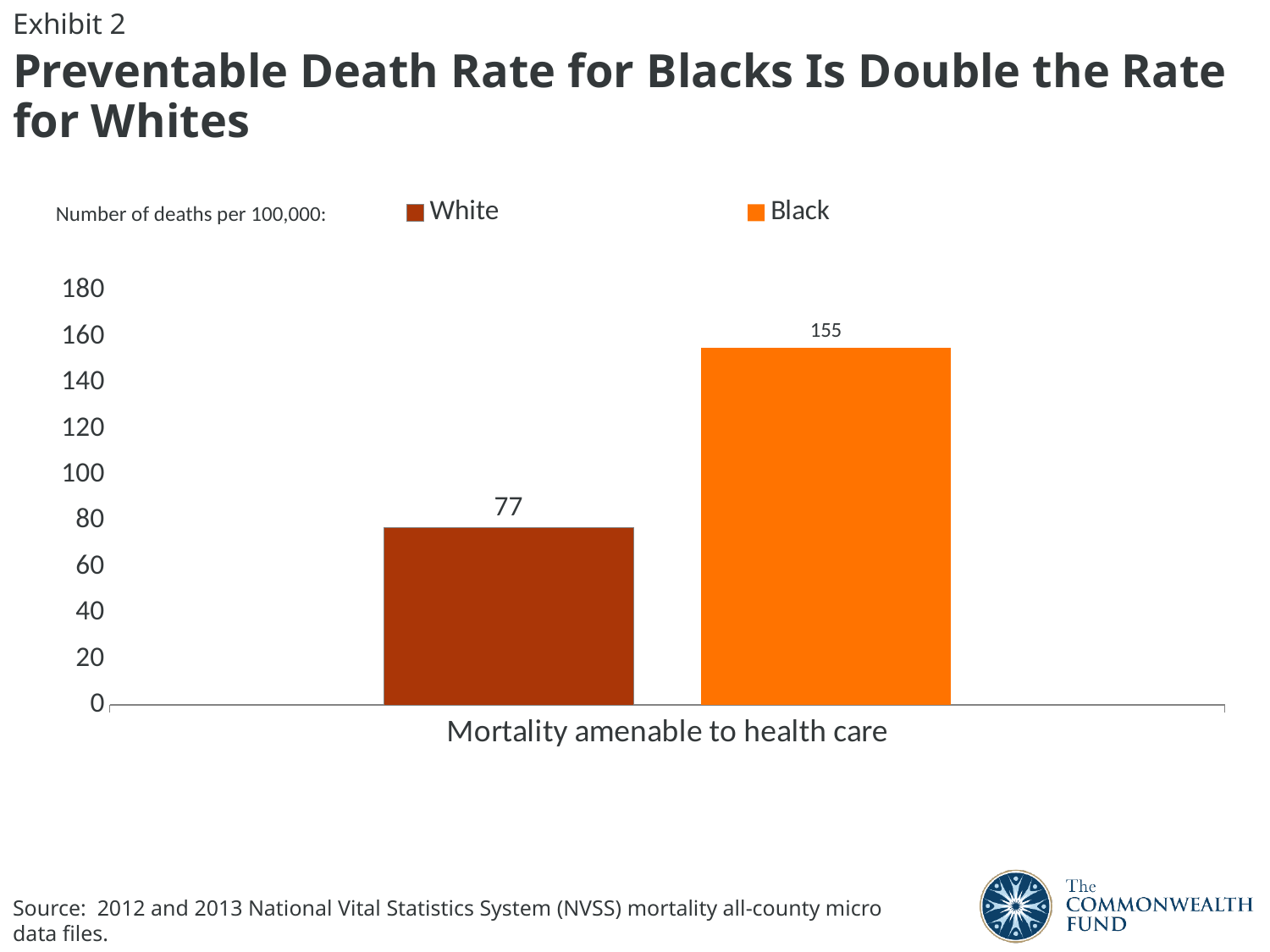
Is the value for White greater or less than 80? less Which series has the lower value? White What is the difference between the Black and White values? 78 What kind of chart is shown on the slide? bar chart What is the highest value shown on the y axis? 180 How many series does the legend list? 2 What is the value for Black in the chart? 155 What unit is stated for the values in the chart? Number of deaths per 100,000 Which series has the higher value, White or Black? Black What is the value for White in the chart? 77 What is the category label on the x axis? Mortality amenable to health care Is the value for Black greater or less than 140? greater